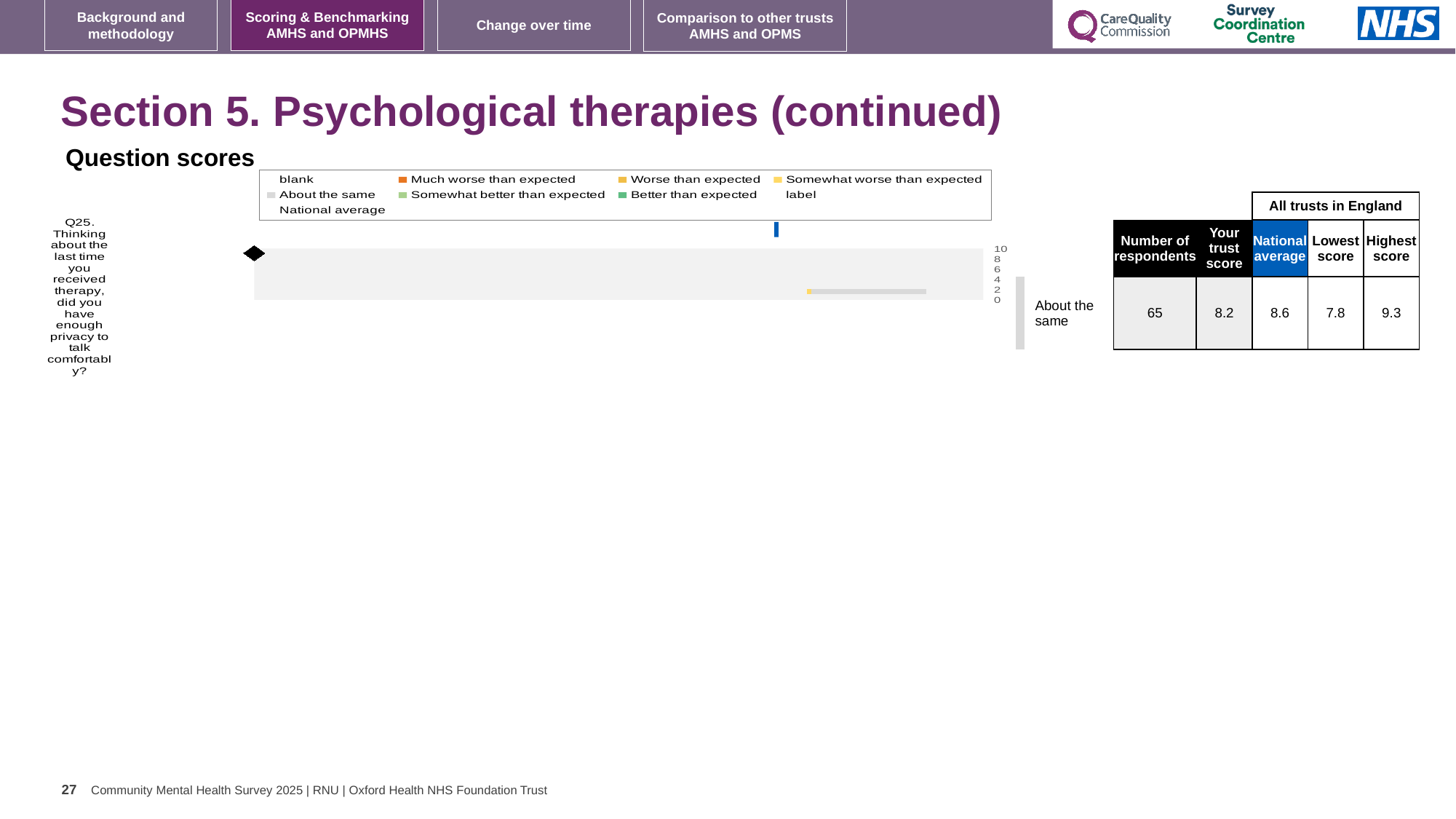
In the table beside the chart, what is the highest score among all trusts in England for Q25? 9.3 In the table beside the chart, how many respondents answered Q25? 65 Which question number is plotted in the Question scores chart? Q25 Which is larger for Q25, the trust score or the national average? national average In the table beside the chart, what is the trust score for Q25? 8.2 In the table beside the chart, what is the national average for Q25? 8.6 In the table beside the chart, what is the lowest score among all trusts in England for Q25? 7.8 How many questions are plotted in the Question scores chart? 1 What benchmark category label is shown next to the bar for Q25? About the same What kind of chart is shown under 'Question scores'? bar chart What is the difference between the highest score and the lowest score for Q25 in the table? 1.5 What is the highest value shown on the chart's score axis? 10